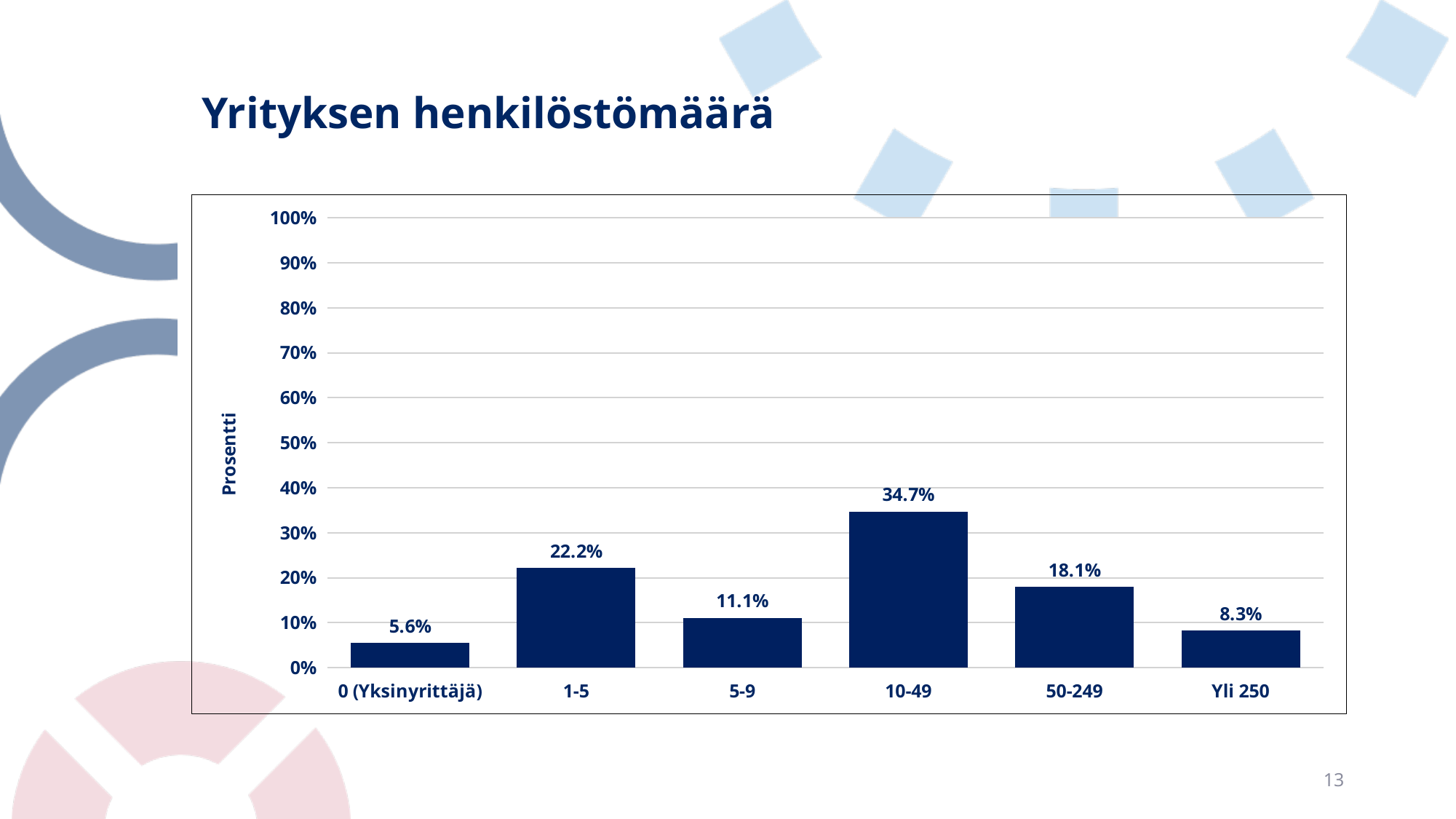
Is the value for 10-49 greater or less than 30%? greater What is the value for the 0 (Yksinyrittäjä) category? 5.6% What is the difference between the values for 10-49 and 50-249? 16.6% What is the label of the y axis? Prosentti What kind of chart is shown on the slide? bar chart How many categories are shown on the x axis? 6 What is the difference between the values for 1-5 and 5-9? 11.1% Which is larger, the value for 1-5 or the value for Yli 250? 1-5 Which category has the lowest value? 0 (Yksinyrittäjä) What is the value for the 50-249 category? 18.1% Which category has the highest value? 10-49 What is the value for the 10-49 category? 34.7%